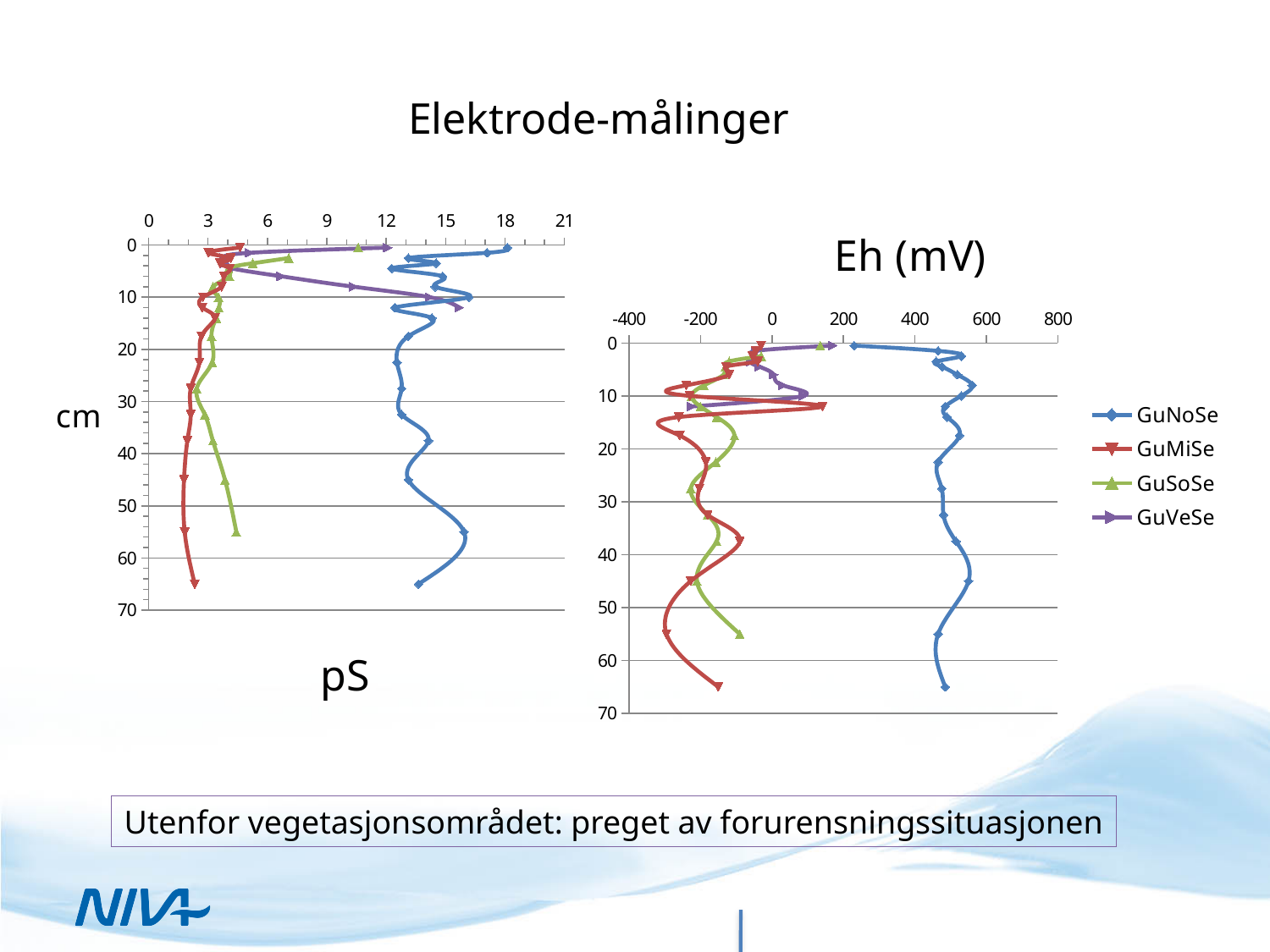
What is the maximum value shown on the x axis of the Eh (mV) chart? 800 In the pS chart on the left, is the value for GuMiSe at 65 cm depth greater or less than 3? less In the Eh (mV) chart, which series has the highest values across the depth profile? GuNoSe In the pS chart on the left, is the value for GuNoSe at 55 cm depth greater or less than 15? greater In the pS chart on the left, which series has the larger value at 55 cm depth, GuNoSe or GuSoSe? GuNoSe What are the series names listed in the legend? GuNoSe, GuMiSe, GuSoSe, GuVeSe How many series does the legend on the slide list? 4 In the Eh (mV) chart, which series has the larger value at 55 cm depth, GuNoSe or GuMiSe? GuNoSe In the Eh (mV) chart, is the value for GuNoSe at 65 cm depth greater or less than 400? greater What kind of chart is the Eh (mV) chart on the right? line chart